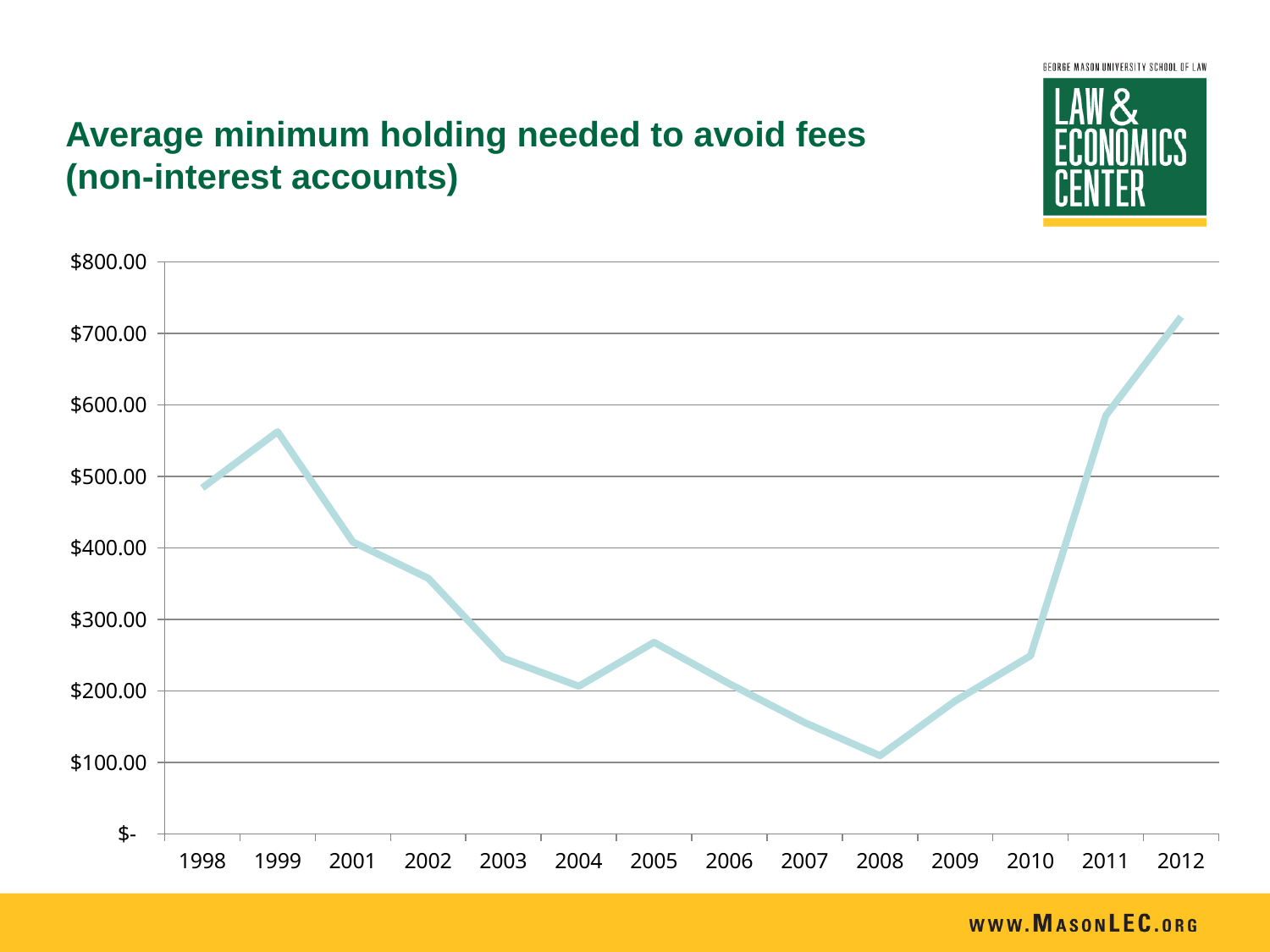
Is the value for 2008 greater or less than $200.00? less How many years are plotted along the x axis? 14 What kind of chart is shown on the slide? line chart Which year has the highest average minimum holding? 2012 Is the value for 2003 greater or less than $300.00? less Which year has a larger value, 1999 or 2001? 1999 Is the value for 1999 greater or less than $500.00? greater Which year has a larger value, 2004 or 2005? 2005 Do the values rise or fall from 2008 to 2012? rise What is the title of the chart on the slide? Average minimum holding needed to avoid fees (non-interest accounts) Which year has the lowest average minimum holding? 2008